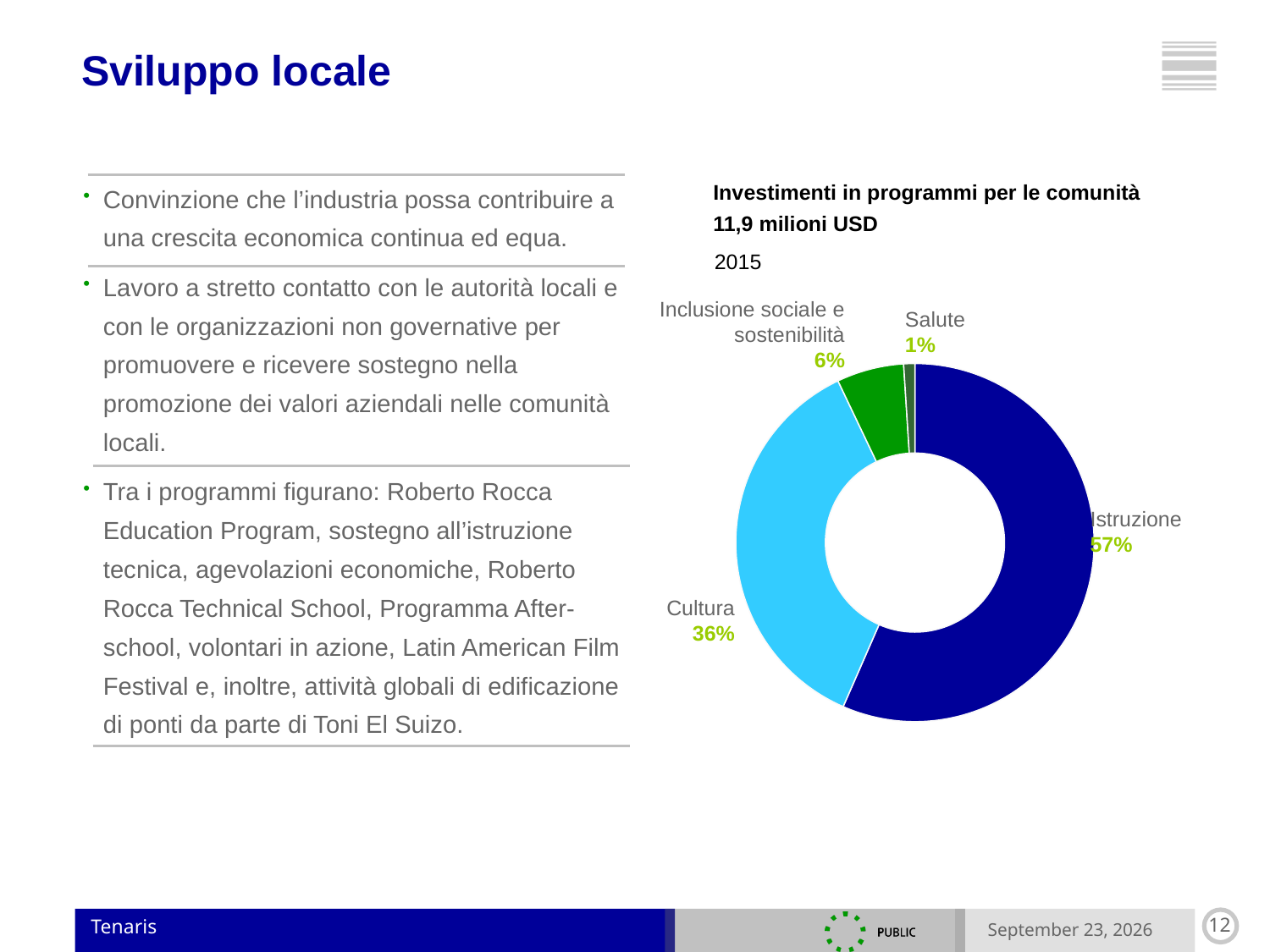
Which category has the smallest share in the donut chart? Salute What is the title of the chart on the slide? Investimenti in programmi per le comunità 11,9 milioni USD What type of chart is shown on the slide? Donut chart What is the difference in percentage points between Istruzione and Cultura? 21 How many categories are shown in the donut chart? 4 Which is larger, the share for Cultura or the share for Inclusione sociale e sostenibilità? Cultura Which year does the chart refer to? 2015 What percentage is shown for Cultura in the donut chart? 36% What percentage is shown for Inclusione sociale e sostenibilità? 6% What percentage is shown for Salute in the chart? 1% Which category has the largest share in the donut chart? Istruzione What share of the donut chart does Istruzione represent? 57%